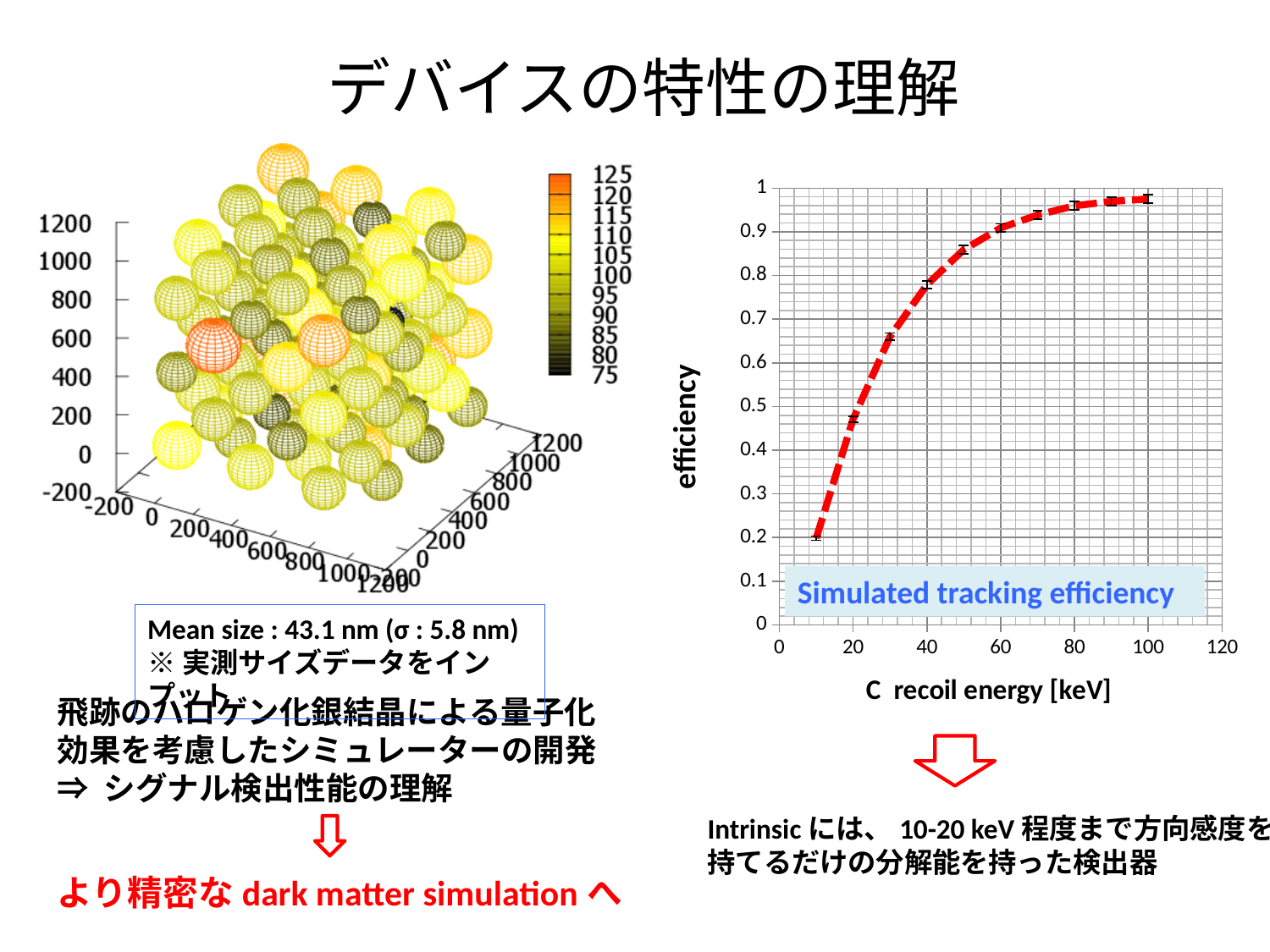
In the right-hand chart (Simulated tracking efficiency), is the efficiency at 40 keV greater or less than 0.7? greater In the right-hand chart (Simulated tracking efficiency), which has the higher efficiency, 20 keV or 40 keV? 40 keV In the right-hand chart (Simulated tracking efficiency), is the efficiency at 100 keV greater or less than 0.9? greater In the right-hand chart (Simulated tracking efficiency), at which C recoil energy is the efficiency lowest? 10 keV In the right-hand chart (Simulated tracking efficiency), is the efficiency at 10 keV greater or less than 0.3? less In the right-hand chart (Simulated tracking efficiency), how many data points are plotted? 10 In the right-hand chart (Simulated tracking efficiency), does the efficiency rise or fall as C recoil energy increases? rise In the right-hand chart (Simulated tracking efficiency), what kind of chart is it? line chart In the right-hand chart (Simulated tracking efficiency), what is the label of the x axis? C recoil energy [keV] In the left-hand 3D chart, what is the highest value shown on the colour scale? 125